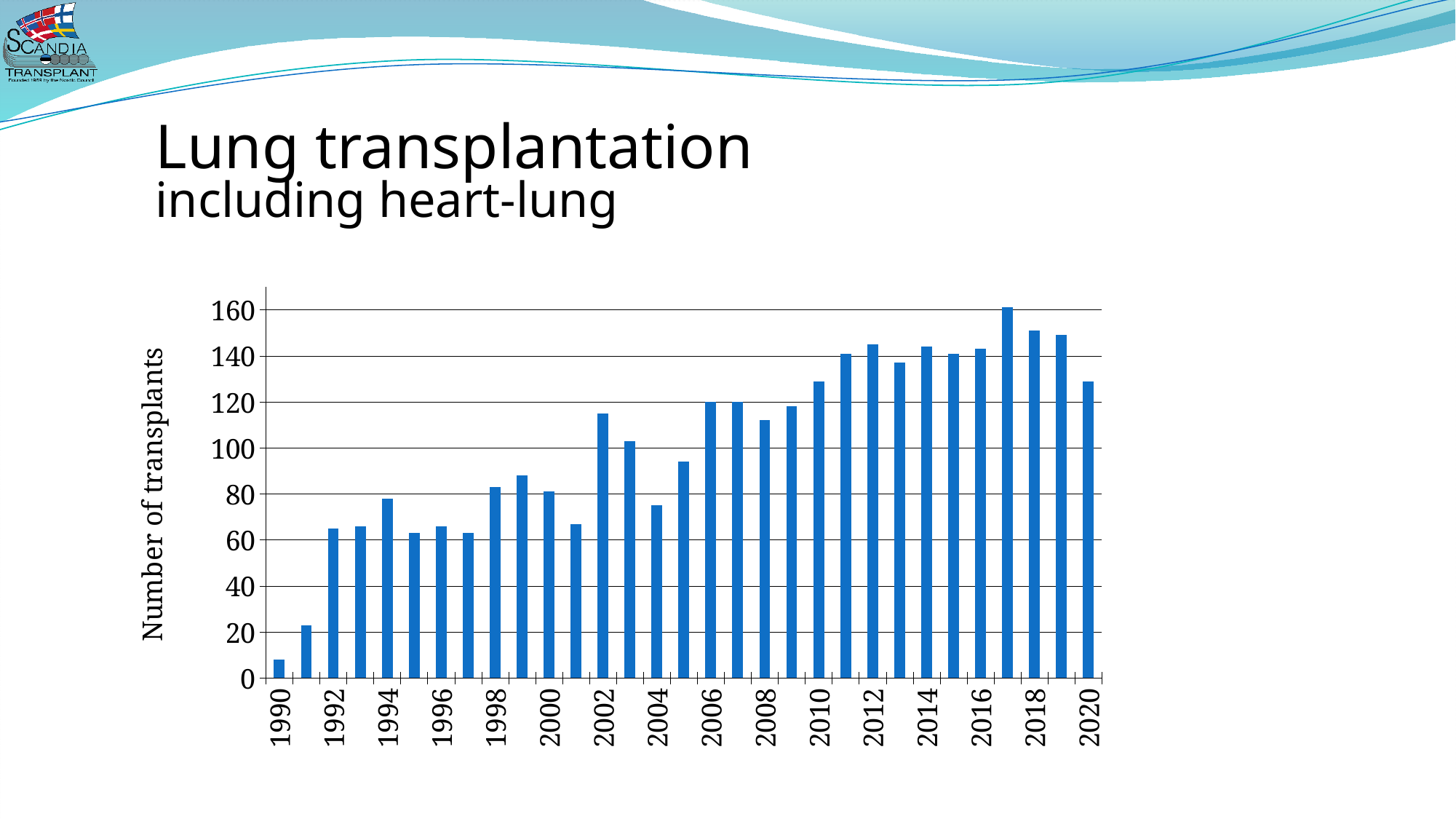
Is the number of transplants in 2002 greater or less than 100? greater What is the label on the vertical axis of the chart? Number of transplants Which year has the lowest number of transplants? 1990 Is the number of transplants in 2001 greater or less than 80? less Is the number of transplants in 2020 greater or less than 120? greater Which year has the highest number of transplants? 2017 Overall, do the number of transplants rise or fall from 1990 to 2020? rise Which year had more transplants, 2017 or 2020? 2017 Which year had more transplants, 2002 or 2003? 2002 What kind of chart is shown on the slide? bar chart How many years (bars) are plotted in the chart? 31